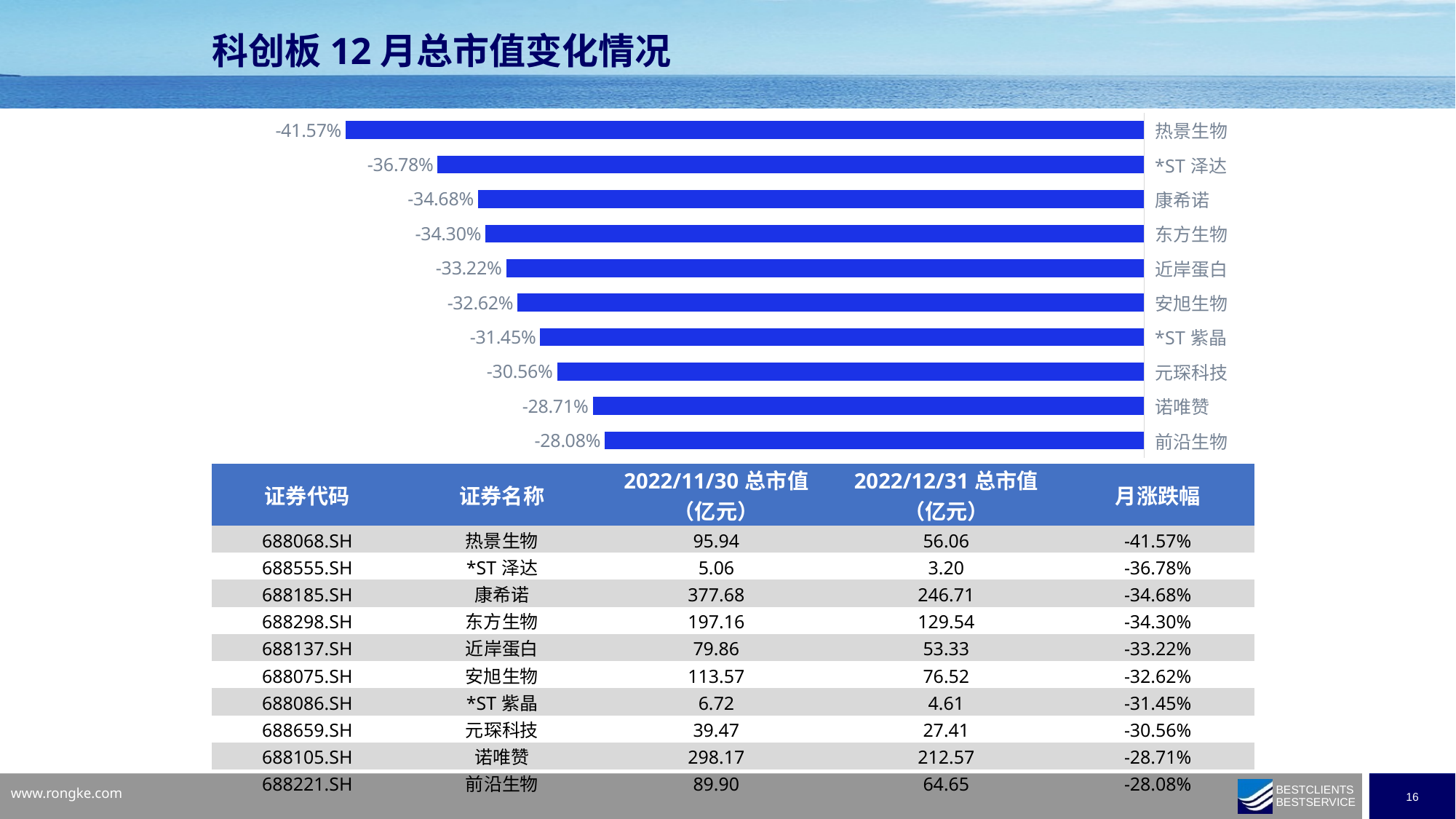
Which company has the smallest decline (highest value) in the bar chart? 前沿生物 What is the difference in percentage points between the values for 热景生物 and 前沿生物? 13.49 percentage points What is the value shown for 元琛科技 in the bar chart? -30.56% What is the value shown for 前沿生物 in the bar chart? -28.08% What is the value shown for 康希诺 in the bar chart? -34.68% What kind of chart is shown on the slide? Bar chart Which company shows a larger decline, *ST 泽达 or 诺唯赞? *ST 泽达 Which company has the largest decline (lowest value) in the bar chart? 热景生物 What is the title of the slide containing the chart? 科创板 12 月总市值变化情况 What is the difference in percentage points between the values for 康希诺 and 东方生物? 0.38 percentage points How many companies are shown in the bar chart? 10 What is the value shown for 热景生物 in the bar chart? -41.57%